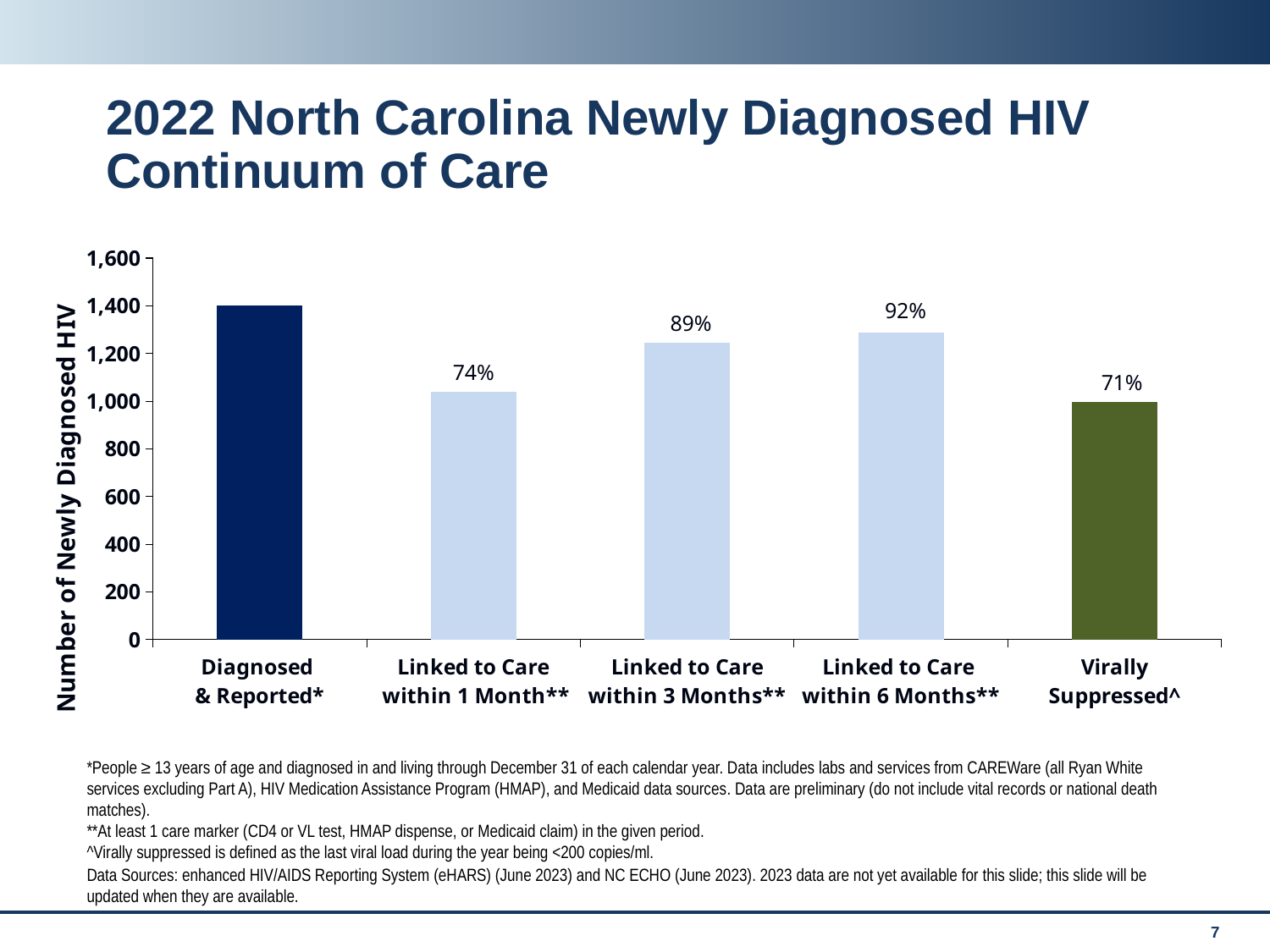
Is the value for Virally Suppressed^ greater or less than 1,200? less Which category has the lowest percentage label in the chart? Virally Suppressed^ What percentage is labelled on the bar for Virally Suppressed^? 71% What percentage is labelled on the bar for Linked to Care within 3 Months**? 89% What percentage is labelled on the bar for Linked to Care within 6 Months**? 92% Is the value for Diagnosed & Reported* greater or less than 1,200? greater What kind of chart is shown on the slide? bar chart What is the difference in percentage points between the labels for Linked to Care within 6 Months** and Linked to Care within 1 Month**? 18 percentage points What is the title of the vertical axis of the chart? Number of Newly Diagnosed HIV How many categories are shown on the x axis of the chart? 5 Which category has the tallest bar in the chart? Diagnosed & Reported* What percentage is labelled on the bar for Linked to Care within 1 Month**? 74%